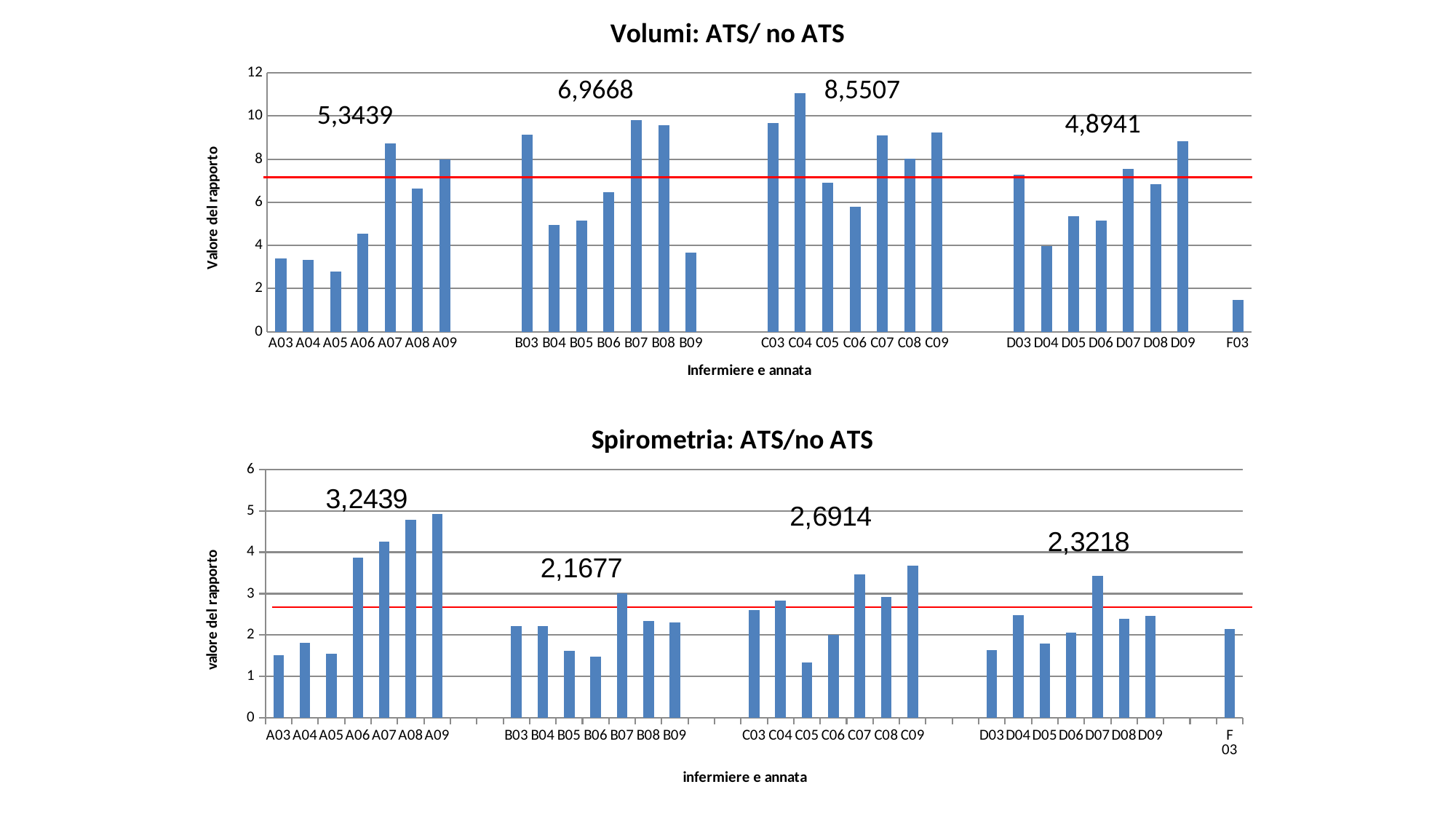
In the 'Volumi: ATS/ no ATS' chart, which category has the lowest value? F03 In the 'Spirometria: ATS/no ATS' chart, which is larger, the value for C07 or the value for C05? C07 In the 'Volumi: ATS/ no ATS' chart, which is larger, the value for B07 or the value for B09? B07 In the 'Volumi: ATS/ no ATS' chart, which category has the highest value? C04 In the 'Volumi: ATS/ no ATS' chart, what kind of chart is used? bar chart In the 'Volumi: ATS/ no ATS' chart, is the value for A05 greater or less than 4? less In the 'Spirometria: ATS/no ATS' chart, what number is printed above the A group of bars? 3,2439 In the 'Volumi: ATS/ no ATS' chart, what number is printed above the C group of bars? 8,5507 How many categories are plotted on the x axis of the 'Volumi: ATS/ no ATS' chart? 29 In the 'Spirometria: ATS/no ATS' chart, is the value for A08 greater or less than 4? greater In the 'Spirometria: ATS/no ATS' chart, is the value for C05 greater or less than 2? less